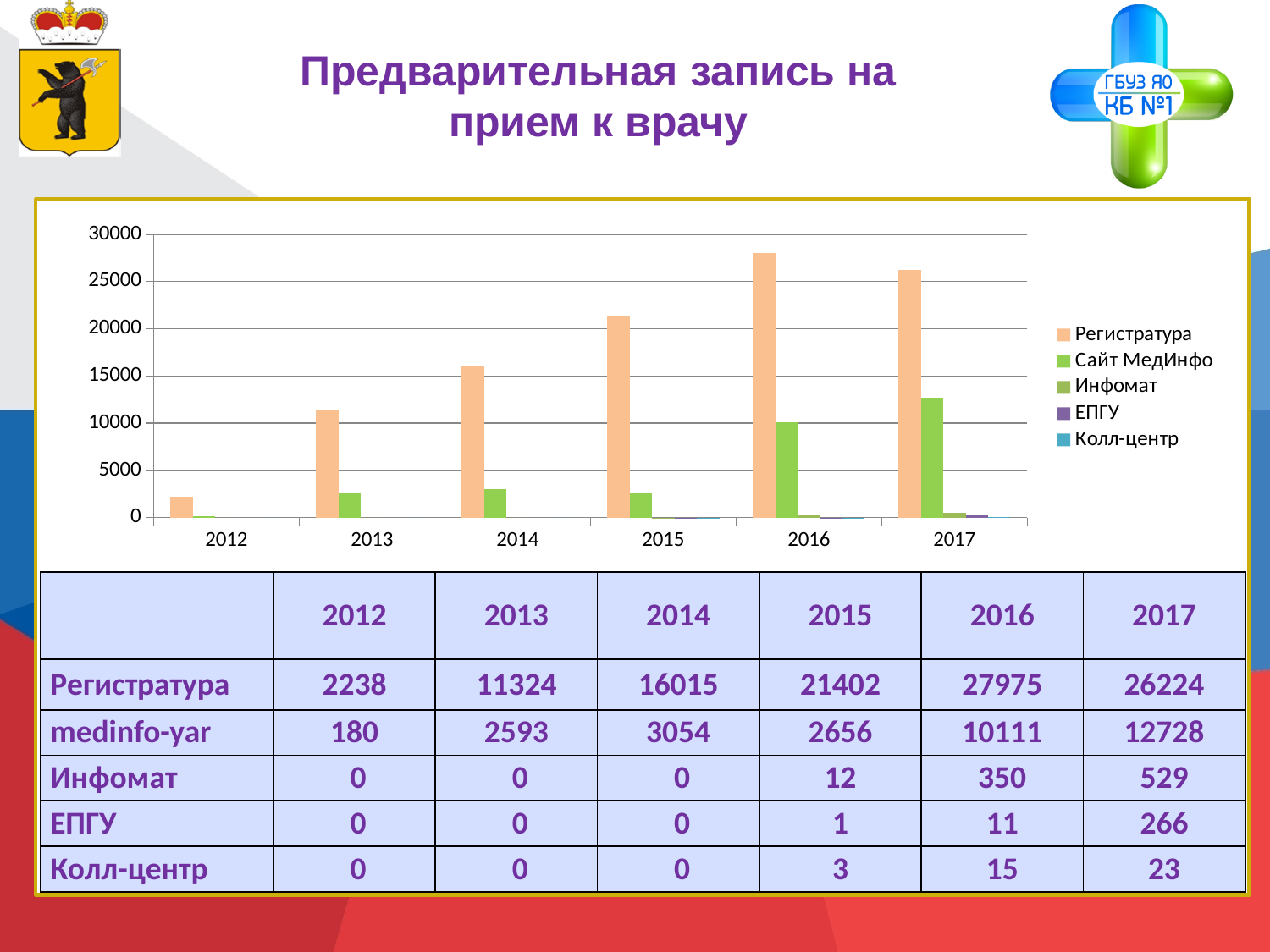
How many series does the chart legend list? 5 Which is larger in 2017: Регистратура or Сайт МедИнфо? Регистратура Which year has the lowest value for Регистратура? 2012 What is the value for Регистратура in 2016, as printed in the table below the chart? 27975 What is the value for Сайт МедИнфо (medinfo-yar) in 2017, as printed in the table below the chart? 12728 Does the value for Сайт МедИнфо rise or fall from 2015 to 2017? rise Is the value for Сайт МедИнфо in 2014 greater or less than 5000? less Using the values printed in the table, what is the difference between Регистратура in 2016 and Регистратура in 2017? 1751 Is the value for Регистратура in 2015 greater or less than 20000? greater Which year has the highest value for Регистратура? 2016 What kind of chart is shown on the slide? bar chart How many years are shown along the x axis of the chart? 6